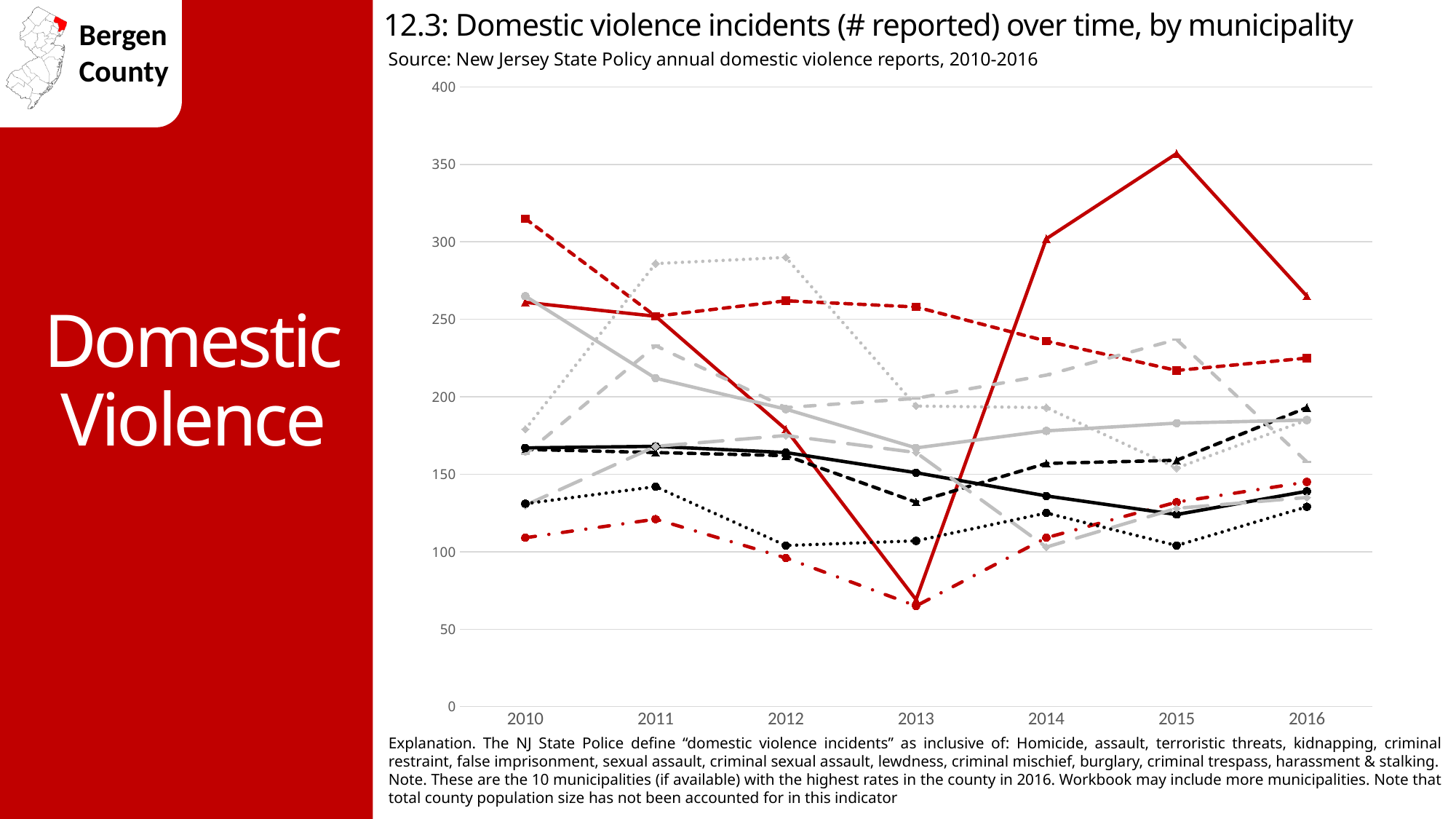
In which year does the solid red line reach its lowest value? 2013 Is the value of the solid red line in 2015 greater or less than 300? greater Does the solid black line rise or fall from 2010 to 2015? Fall Is the value of the dashed red line with square markers in 2010 greater or less than 300? greater Which line has the higher value in 2015: the solid red line or the dashed red line with square markers? The solid red line What kind of chart is shown on the slide? Line chart Is the value of the solid red line in 2013 greater or less than 100? less In which year does the solid red line reach its highest value? 2015 What is the highest value shown on the y axis? 400 How many years are shown along the x axis of the chart? 7 What is the first year shown on the x axis? 2010